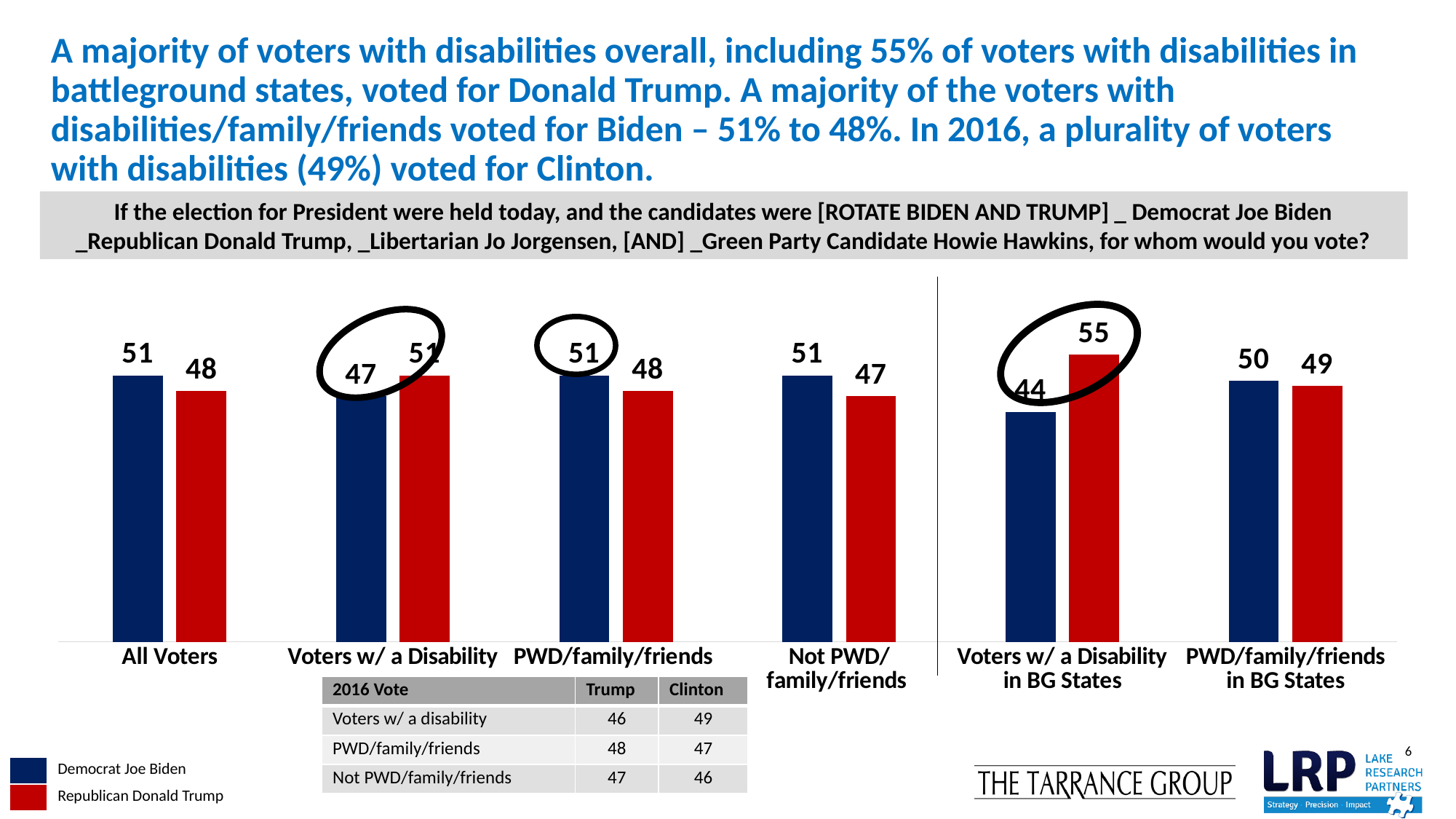
What kind of chart is shown on the slide? Bar chart What is the difference between the Trump and Biden values among Voters w/ a Disability in BG States? 11 What is the value for Democrat Joe Biden among Voters w/ a Disability? 47 Among Voters w/ a Disability, which is larger: the value for Democrat Joe Biden or Republican Donald Trump? Republican Donald Trump Which category has the highest value for Republican Donald Trump? Voters w/ a Disability in BG States How many categories are shown on the x axis of the chart? 6 What is the value for Republican Donald Trump among Voters w/ a Disability in BG States? 55 What is the value for Democrat Joe Biden among PWD/family/friends in BG States? 50 How many series does the legend list? 2 What is the difference between the Biden and Trump values among Not PWD/family/friends? 4 What is the value for Republican Donald Trump among Not PWD/family/friends? 47 Which category has the lowest value for Democrat Joe Biden? Voters w/ a Disability in BG States